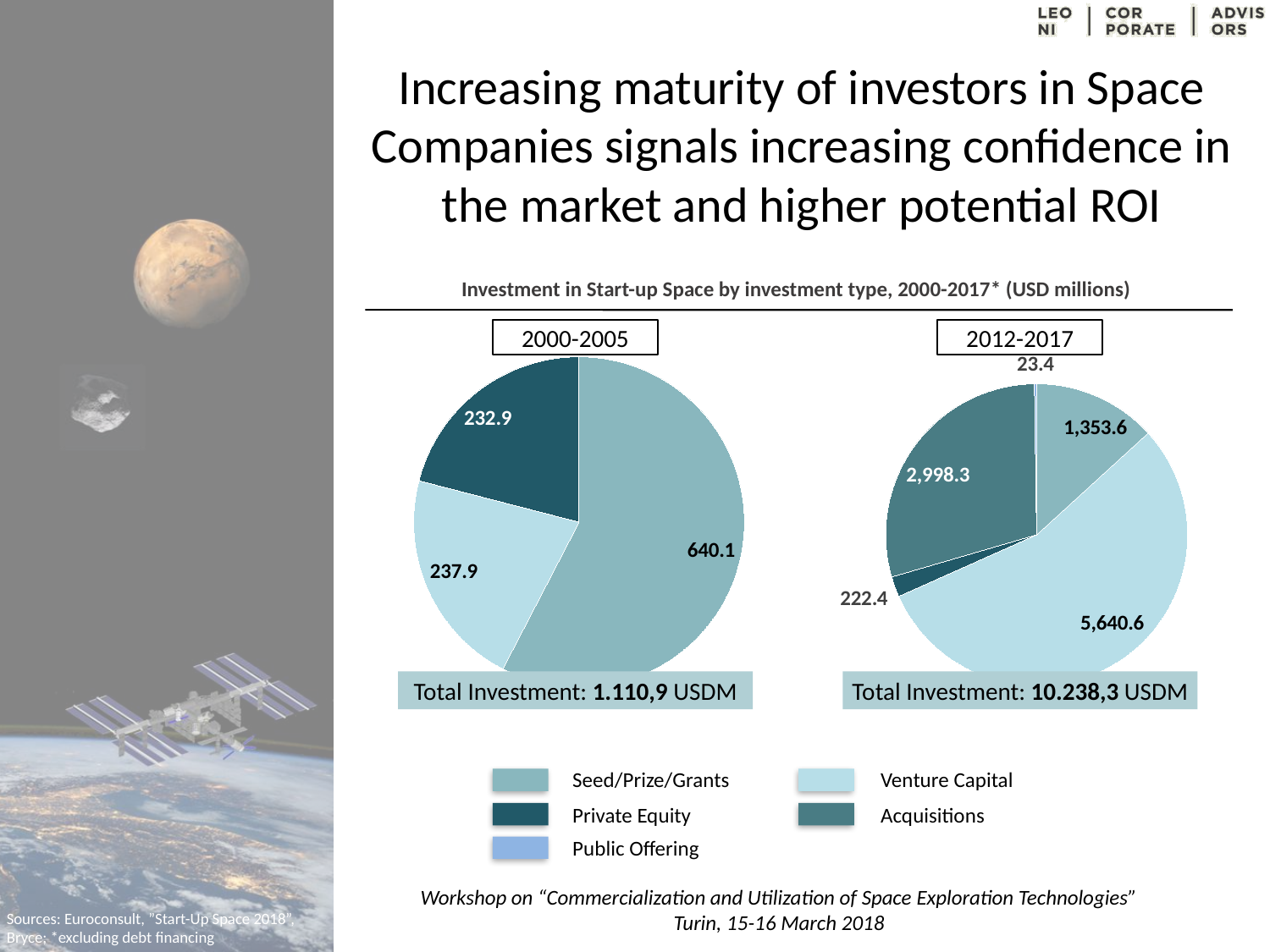
How many slices does the 2000-2005 pie chart have? 3 What is the total investment shown for the 2012-2017 pie chart? 10.238,3 USDM In the 2000-2005 pie chart, what is the difference between the largest slice (640.1) and the 237.9 slice? 402.2 In the 2012-2017 pie chart, what is the value of the Acquisitions slice? 2,998.3 What type of charts are shown on the slide? Pie charts In the 2012-2017 pie chart, what is the value of the Venture Capital slice? 5,640.6 In the 2012-2017 pie chart, what is the value of the smallest slice? 23.4 How many slices does the 2012-2017 pie chart have? 5 In the 2000-2005 pie chart, what is the value of the largest slice? 640.1 In the 2012-2017 pie chart, which is larger: Venture Capital or Acquisitions? Venture Capital In the 2000-2005 pie chart, what is the value of the smallest slice? 232.9 How many investment types does the legend list? 5